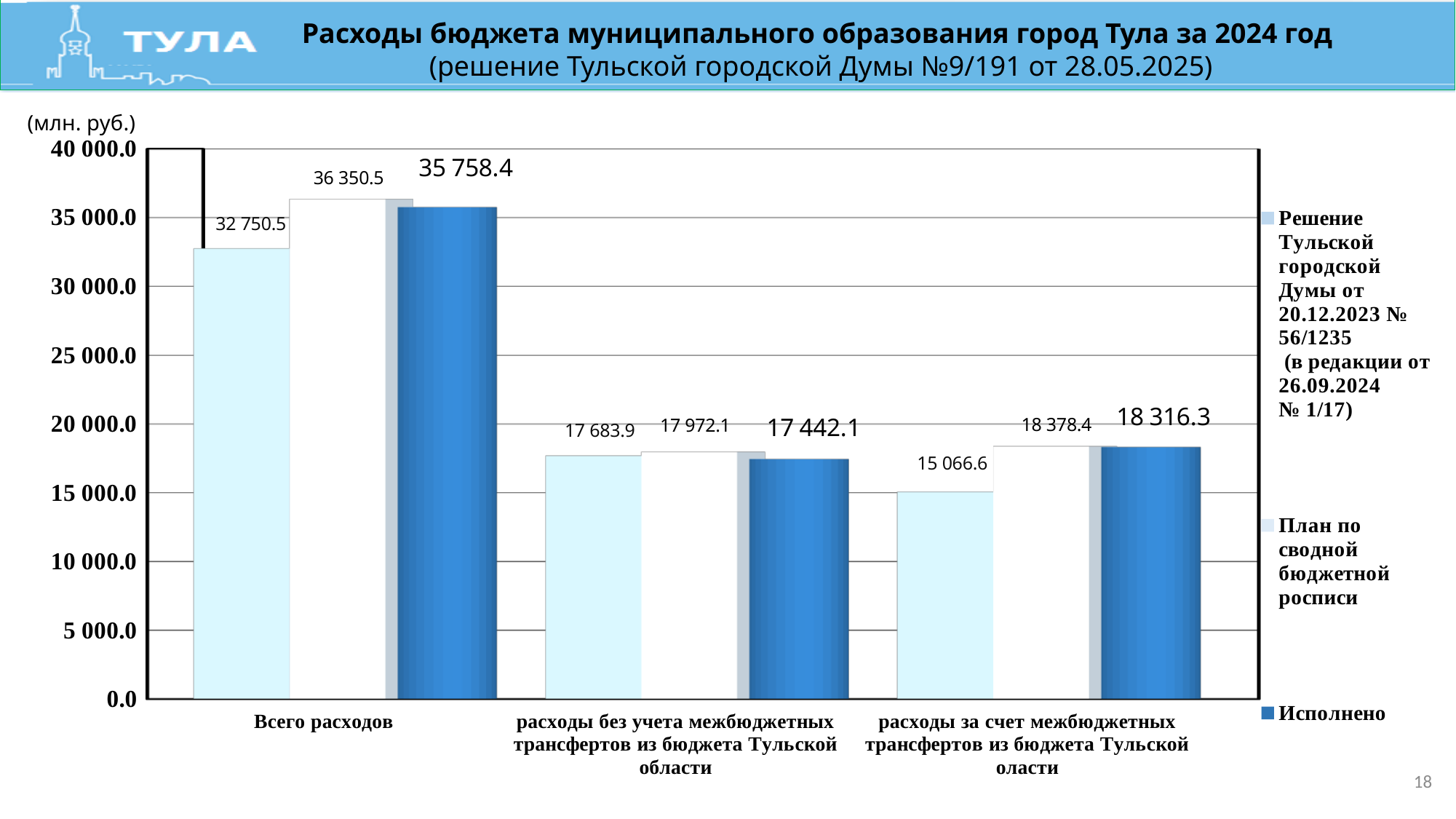
What is the value of "Исполнено" for "Всего расходов"? 35 758.4 Is the "Исполнено" value larger for "расходы без учета межбюджетных трансфертов" or for "расходы за счет межбюджетных трансфертов"? расходы за счет межбюджетных трансфертов What unit is indicated for the values on the chart? млн. руб. How many categories are shown on the x axis? 3 What is the value of "Исполнено" for "расходы без учета межбюджетных трансфертов из бюджета Тульской области"? 17 442.1 Which category has the lowest value in the "Решение Тульской городской Думы" series? расходы за счет межбюджетных трансфертов из бюджета Тульской оласти What is the value of "План по сводной бюджетной росписи" for "Всего расходов"? 36 350.5 Which category has the highest "Исполнено" value? Всего расходов What is the difference between "План по сводной бюджетной росписи" and "Исполнено" for "Всего расходов"? 592.1 How many series does the legend list? 3 What type of chart is shown on the slide? bar chart What is the value of the "Решение Тульской городской Думы" series for "расходы за счет межбюджетных трансфертов из бюджета Тульской оласти"? 15 066.6